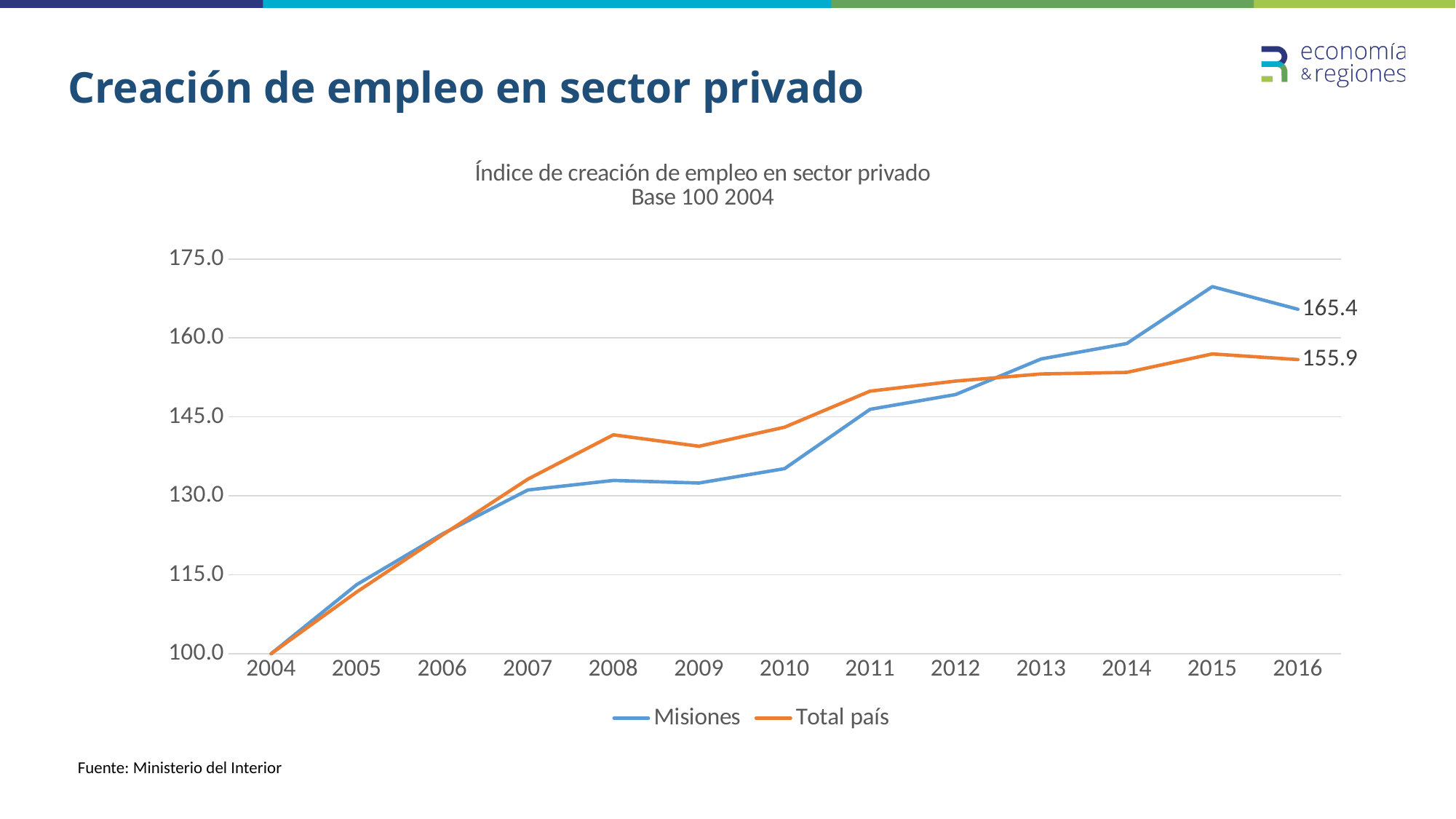
Is the value for Misiones in 2015 greater or less than 160? greater Is the value for Total país in 2008 greater or less than 145? less How many years are shown on the x axis? 13 How many series does the legend list? 2 In which year does the Misiones series reach its highest value? 2015 What is the value for Misiones in 2016? 165.4 In 2016, which series has the higher value, Misiones or Total país? Misiones What is the value for Total país in 2016? 155.9 In 2008, which series has the higher value, Misiones or Total país? Total país What is the difference between the Misiones and Total país values in 2016? 9.5 Does the Total país series rise or fall from 2008 to 2009? Fall What kind of chart is shown on the slide? Line chart